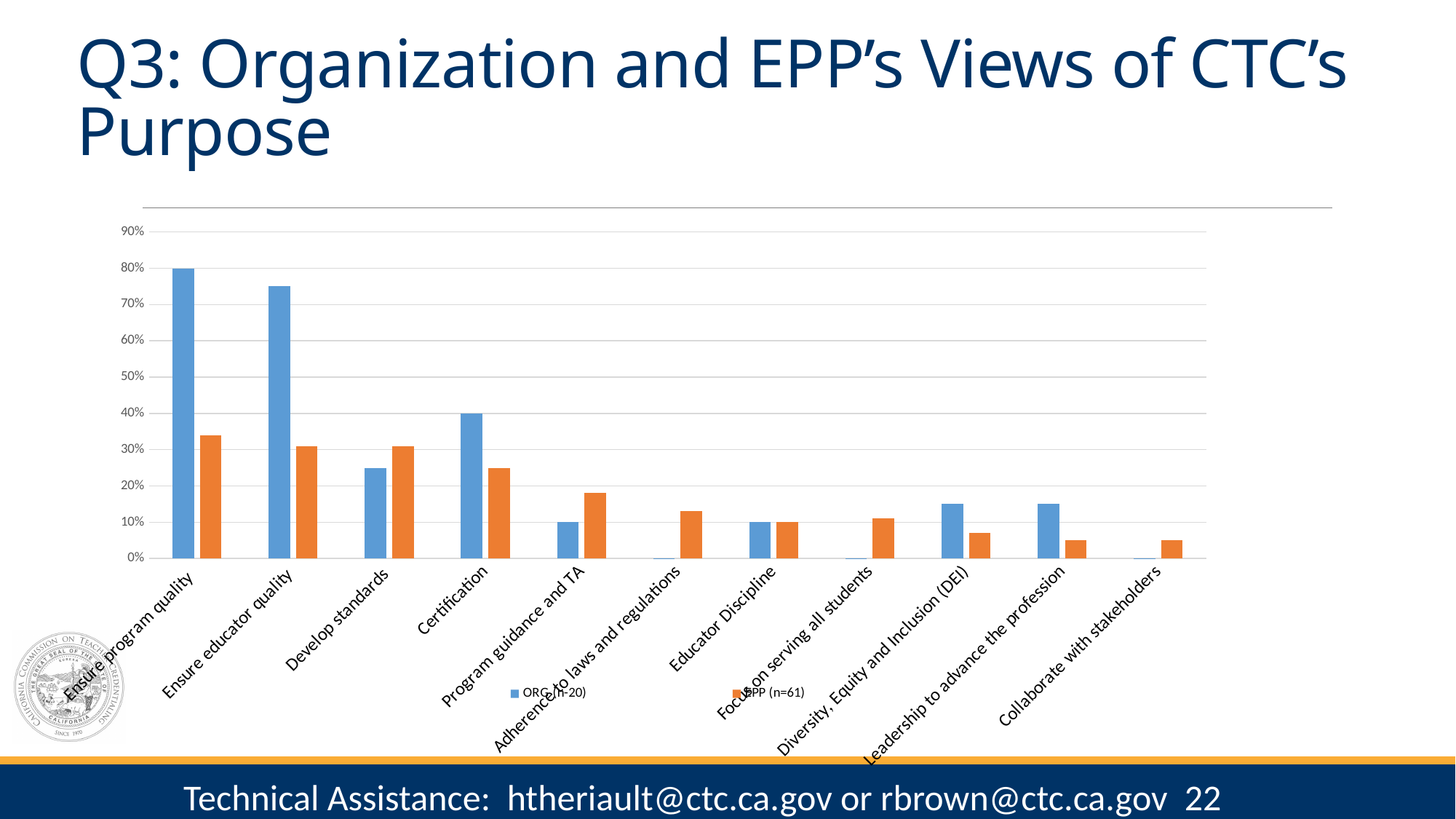
How many series does the legend list? 2 What is the EPP (n=61) value for Educator Discipline? 10% How many categories are shown on the x axis? 11 What colour are the EPP (n=61) bars? orange Which category has the highest ORG (n=20) value? Ensure program quality Is the EPP (n=61) value for Collaborate with stakeholders greater or less than 10%? less For Certification, which series has the larger value, ORG (n=20) or EPP (n=61)? ORG (n=20) Is the ORG (n=20) value for Ensure educator quality greater or less than 70%? greater For Program guidance and TA, which series has the larger value, ORG (n=20) or EPP (n=61)? EPP (n=61) What is the ORG (n=20) value for Ensure program quality? 80% What is the ORG (n=20) value for Certification? 40% What kind of chart is shown on the slide? bar chart